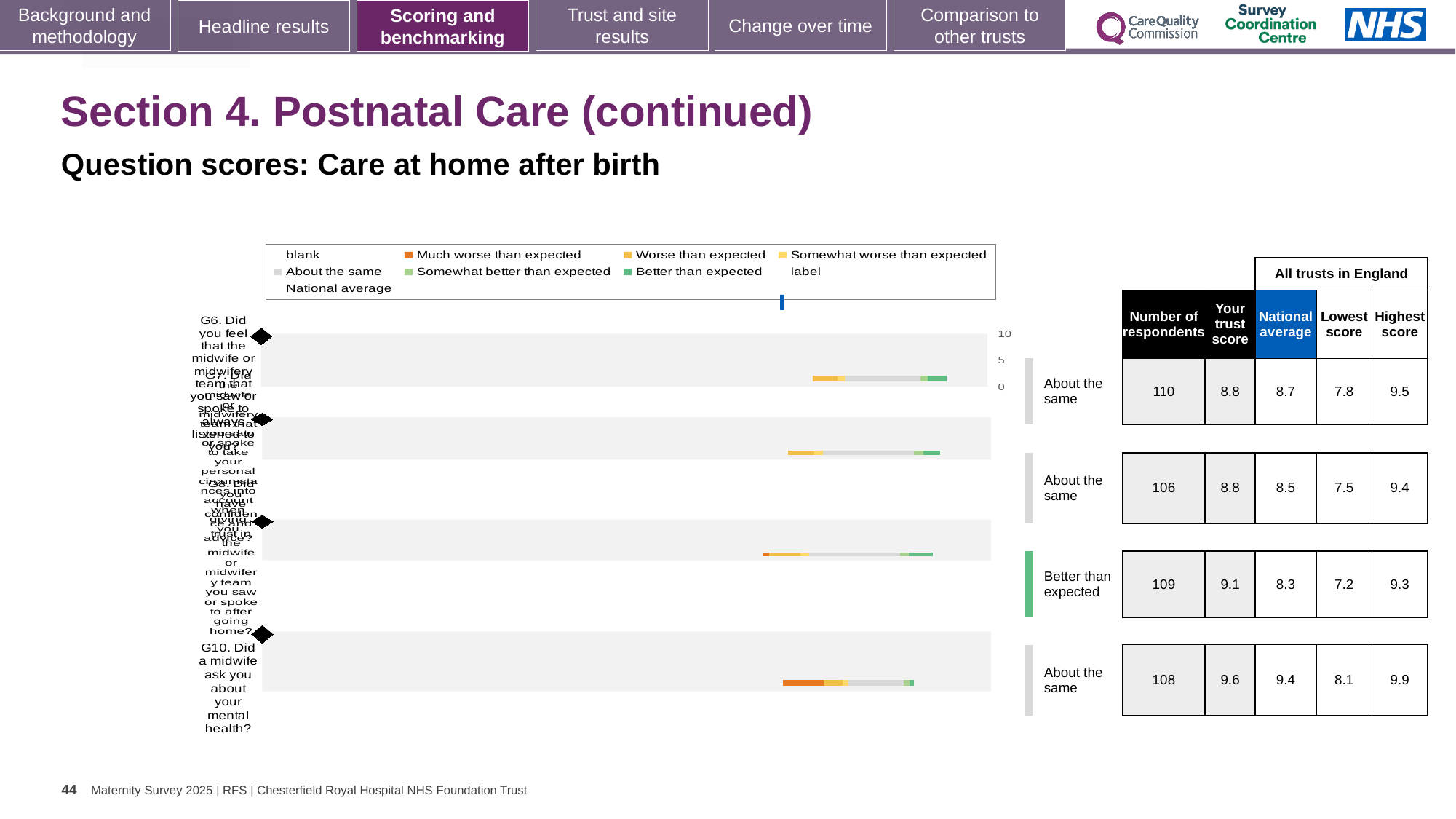
What colour does the legend use for 'Much worse than expected'? orange In the table, what is the number of respondents for G10 (Did a midwife ask you about your mental health?)? 108 In the table, what is the lowest value shown in the 'Lowest score' column? 7.2 In the table, what is the highest score across all trusts in England for G10 (Did a midwife ask you about your mental health?)? 9.9 In the table, what is the national average for G10 (Did a midwife ask you about your mental health?)? 9.4 How many question rows (bars) does the chart show? 4 For G10, what is the difference between the trust score and the national average? 0.2 In the table, which row has the highest 'Your trust score'? G10 (Did a midwife ask you about your mental health?) What colour does the legend use for 'Better than expected'? green How many rows in the table are rated 'About the same'? 3 What kind of chart is shown on the slide? bar chart In the table, what is the trust score for G10 (Did a midwife ask you about your mental health?)? 9.6